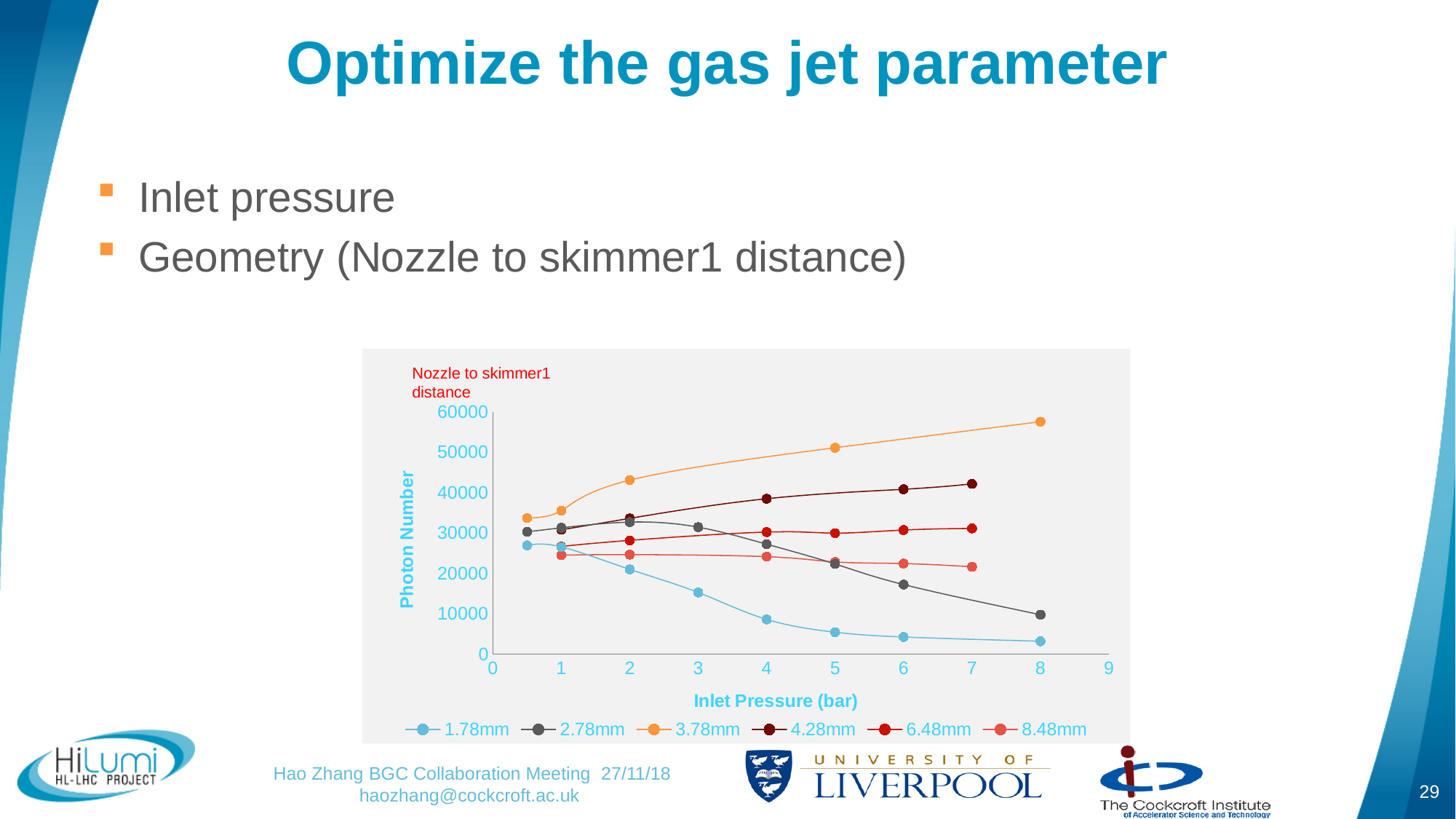
Which series has the highest photon number at 8 bar? 3.78mm What is the title of the y axis? Photon Number What is the title of the x axis? Inlet Pressure (bar) Is the photon number for the 1.78mm series at 5 bar greater or less than 10000? less How many series does the legend list? 6 Does the photon number for the 3.78mm series rise or fall as inlet pressure increases? rise Is the photon number for the 3.78mm series at 8 bar greater or less than 50000? greater What kind of chart is shown on the slide? line chart Which series has the lowest photon number at 8 bar? 1.78mm At 7 bar, which series has the larger photon number, 4.28mm or 6.48mm? 4.28mm Is the photon number for the 2.78mm series at 8 bar greater or less than 20000? less Does the photon number for the 1.78mm series rise or fall as inlet pressure increases? fall